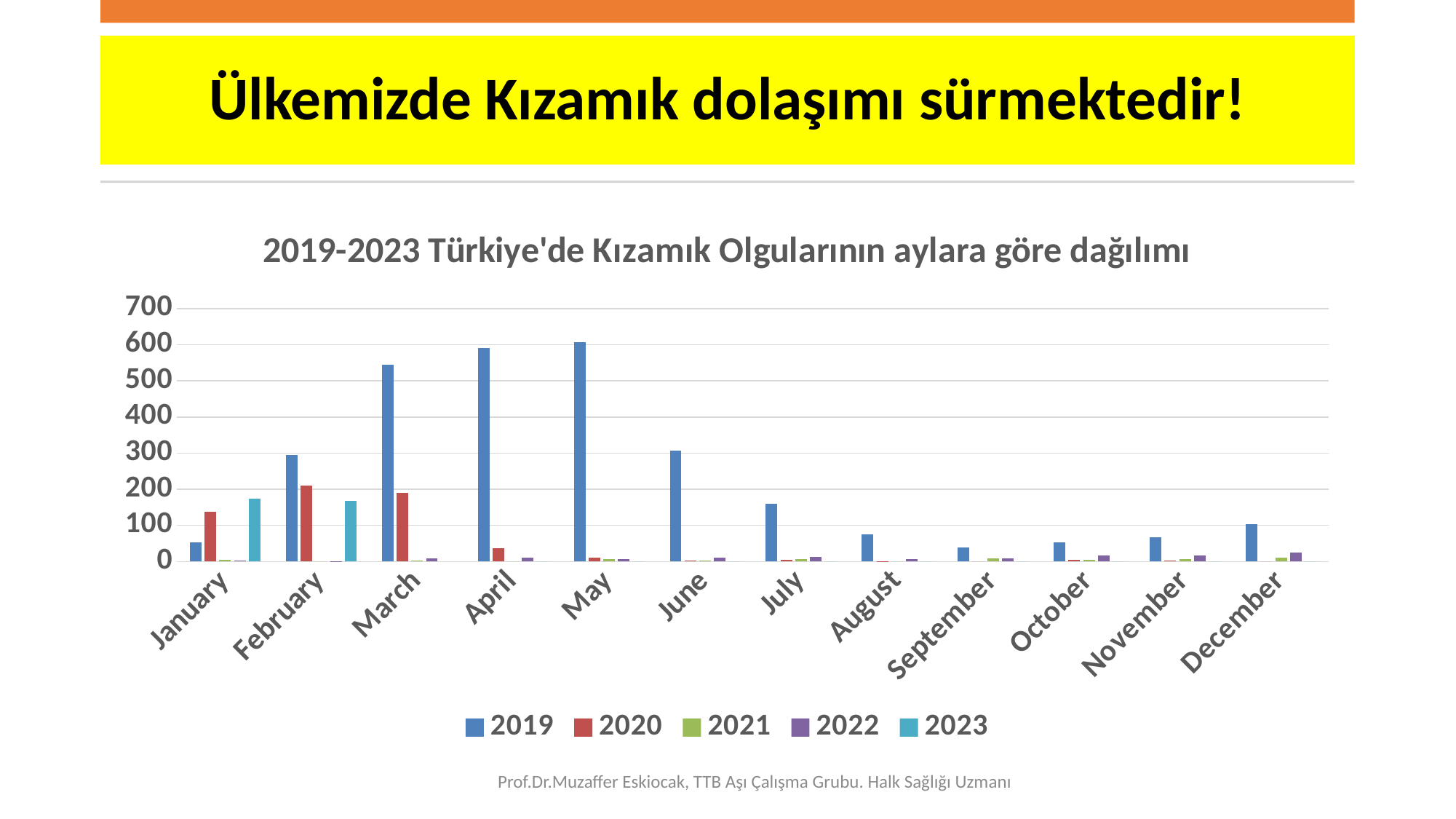
How many months are shown on the x axis? 12 In which month is the 2019 value highest? May In which month is the 2020 value highest? February Is the 2019 value for March greater or less than 500? greater Is the 2019 value for December greater or less than 200? less Is the 2023 value for January greater or less than 100? greater Which is larger in March: the 2019 value or the 2020 value? 2019 What kind of chart is shown on the slide? bar chart Which is larger in January: the 2019 value or the 2023 value? 2023 How many series does the legend list? 5 Do the 2019 values rise or fall from May to September? fall